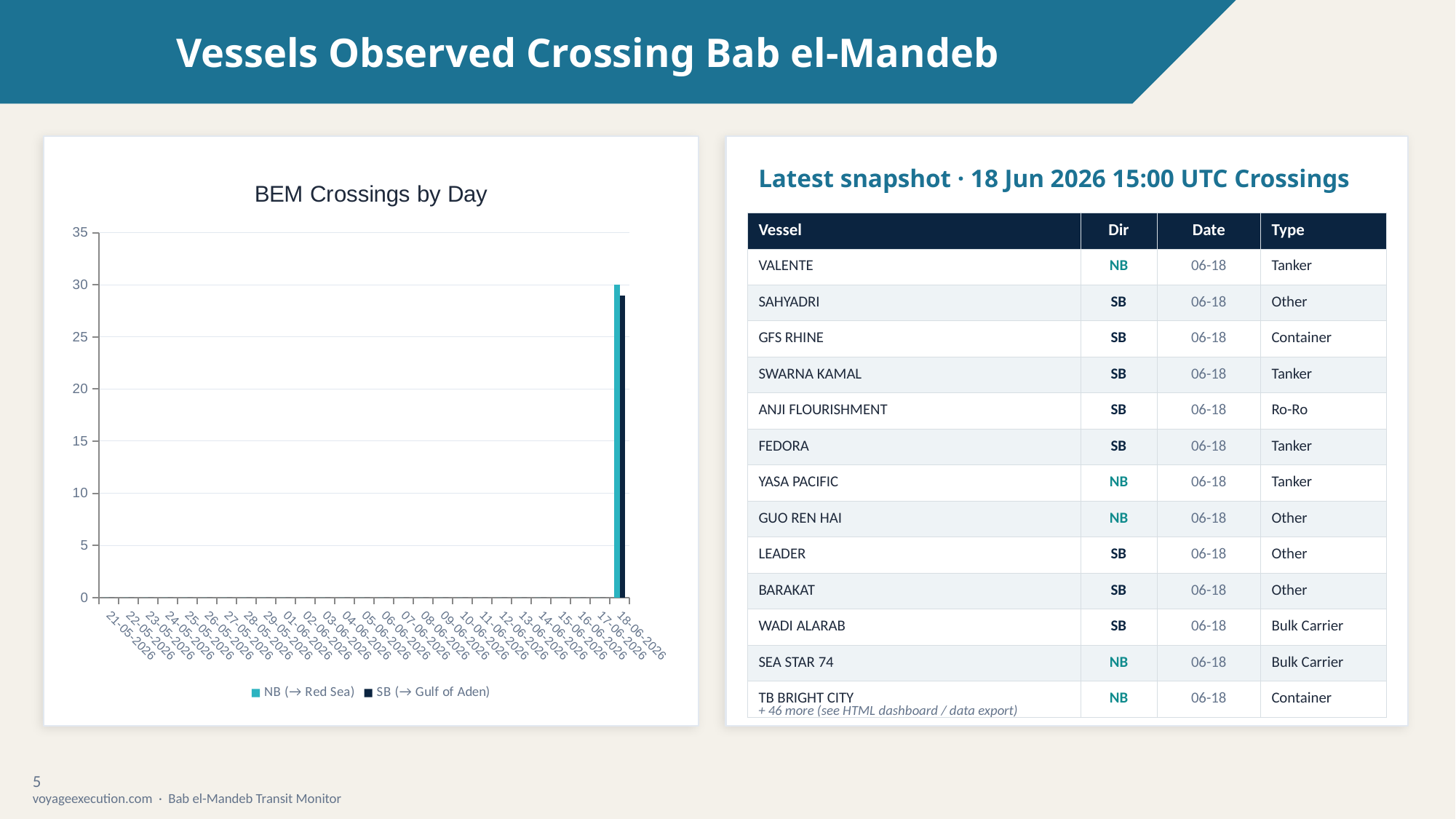
In 'BEM Crossings by Day', which date has the highest SB (→ Gulf of Aden) value? 18-06-2026 In 'BEM Crossings by Day', what is the highest value shown on the y axis? 35 In 'BEM Crossings by Day', which series is shown in dark navy? SB (→ Gulf of Aden) How many series does the legend of 'BEM Crossings by Day' list? 2 In 'BEM Crossings by Day', what is the first date shown on the x axis? 21-05-2026 In 'BEM Crossings by Day', is the SB (→ Gulf of Aden) value for 18-06-2026 greater or less than 35? less In 'BEM Crossings by Day', which date has the highest NB (→ Red Sea) value? 18-06-2026 In 'BEM Crossings by Day', is the NB (→ Red Sea) value for 18-06-2026 greater or less than 25? greater In 'BEM Crossings by Day', is the NB (→ Red Sea) value for 18-06-2026 greater or less than 35? less What is the title of the chart on the left of the slide? BEM Crossings by Day What kind of chart is 'BEM Crossings by Day'? bar chart